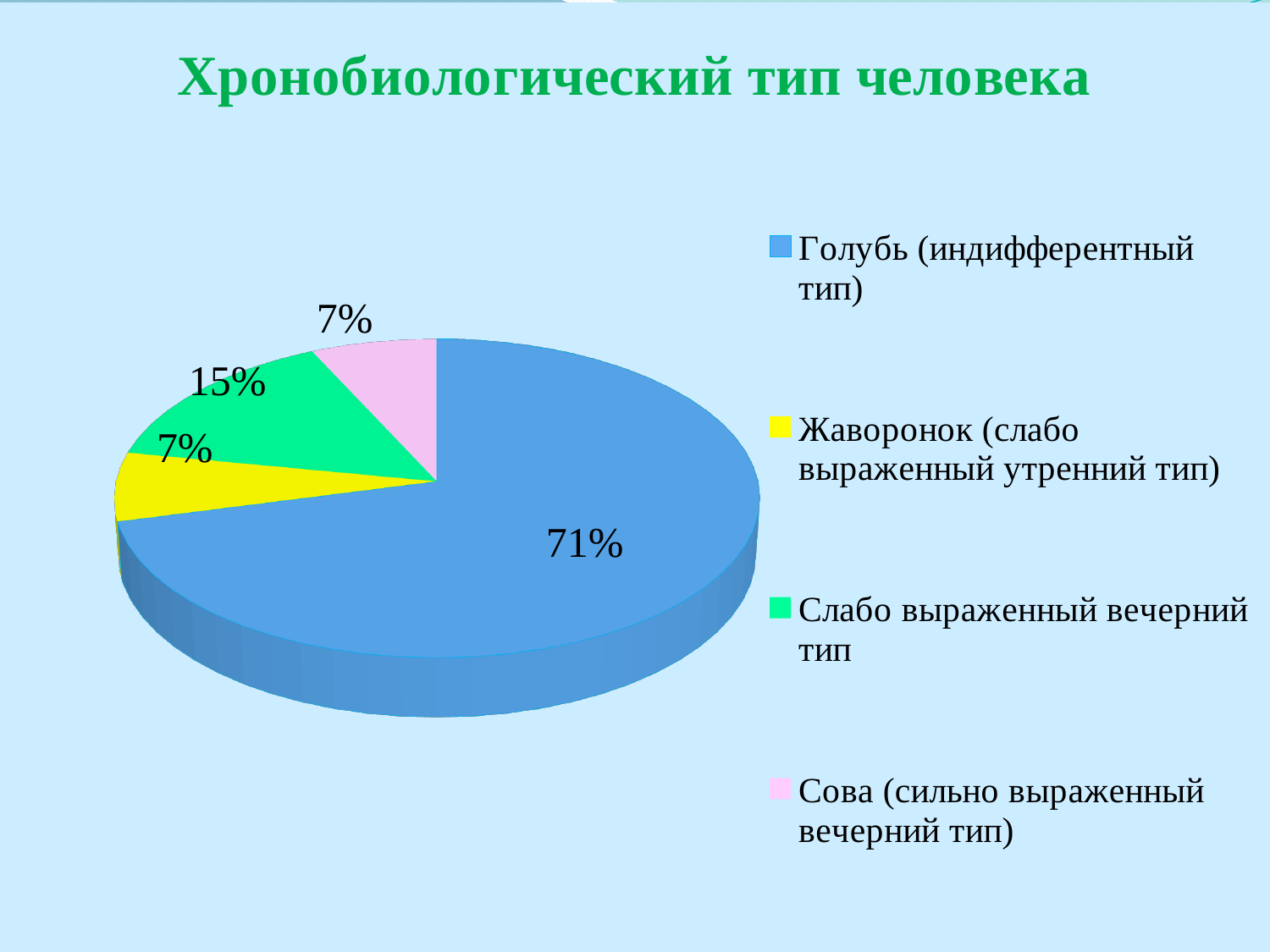
What is the title of the slide? Хронобиологический тип человека What share of the pie does Слабо выраженный вечерний тип have? 15% Which category has the largest slice of the pie? Голубь (индифферентный тип) How many entries does the legend list? 4 What share of the pie does Голубь (индифферентный тип) have? 71% What share of the pie does Жаворонок (слабо выраженный утренний тип) have? 7% What colour is the slice for Жаворонок (слабо выраженный утренний тип)? Yellow What is the difference between the shares of Голубь (индифферентный тип) and Слабо выраженный вечерний тип? 56% What type of chart is shown on the slide? Pie chart How many slices does the pie chart have? 4 Which is larger: the share of Слабо выраженный вечерний тип or the share of Сова (сильно выраженный вечерний тип)? Слабо выраженный вечерний тип